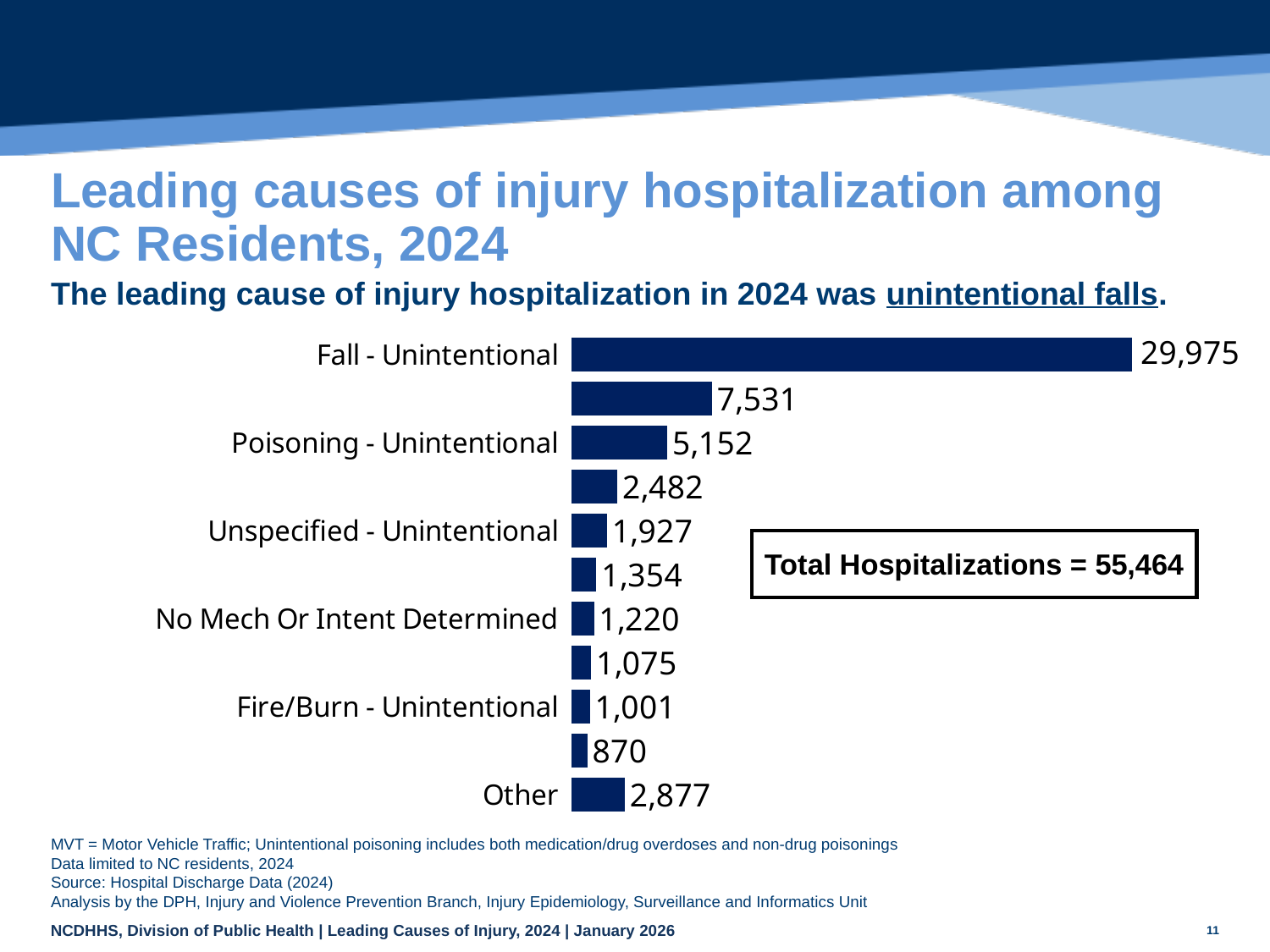
Which is larger, the value for Poisoning - Unintentional or the value for Other? Poisoning - Unintentional What is the value for Fall - Unintentional? 29,975 What is the difference between the values for Fall - Unintentional and Poisoning - Unintentional? 24,823 What is the smallest value shown on any bar in the chart? 870 What kind of chart is shown on the slide? Bar chart How many bars are shown in the chart? 11 What is the value for Fire/Burn - Unintentional? 1,001 What is the value for Unspecified - Unintentional? 1,927 Which category has the highest value? Fall - Unintentional What is the value for No Mech Or Intent Determined? 1,220 What is the value for Other? 2,877 What is the value for Poisoning - Unintentional? 5,152